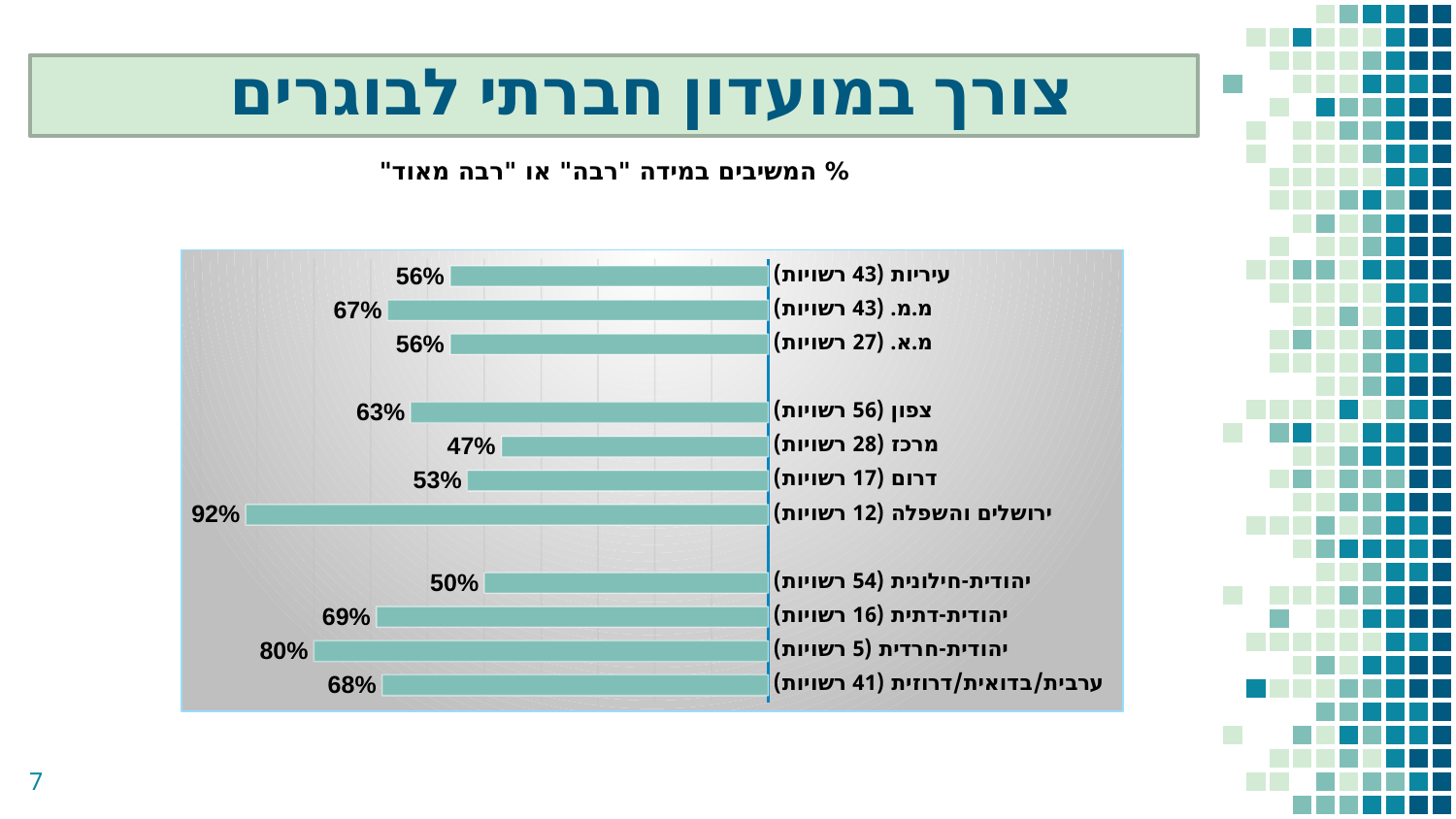
What is the difference between the values for יהודית-דתית (16 רשויות) and יהודית-חילונית (54 רשויות)? 19% What kind of chart is shown on the slide? Bar chart Which category has the lowest value? מרכז (28 רשויות) Which category has the highest value? ירושלים והשפלה (12 רשויות) How many categories are shown in the chart? 11 What is the value for ירושלים והשפלה (12 רשויות)? 92% What is the title of the slide? צורך במועדון חברתי לבוגרים Which is larger, the value for צפון (56 רשויות) or the value for דרום (17 רשויות)? צפון (56 רשויות) What is the value for ערבית/בדואית/דרוזית (41 רשויות)? 68% What is the difference between the values for מ.מ. (43 רשויות) and עיריות (43 רשויות)? 11% What is the value for יהודית-חרדית (5 רשויות)? 80% What is the value for מרכז (28 רשויות)? 47%